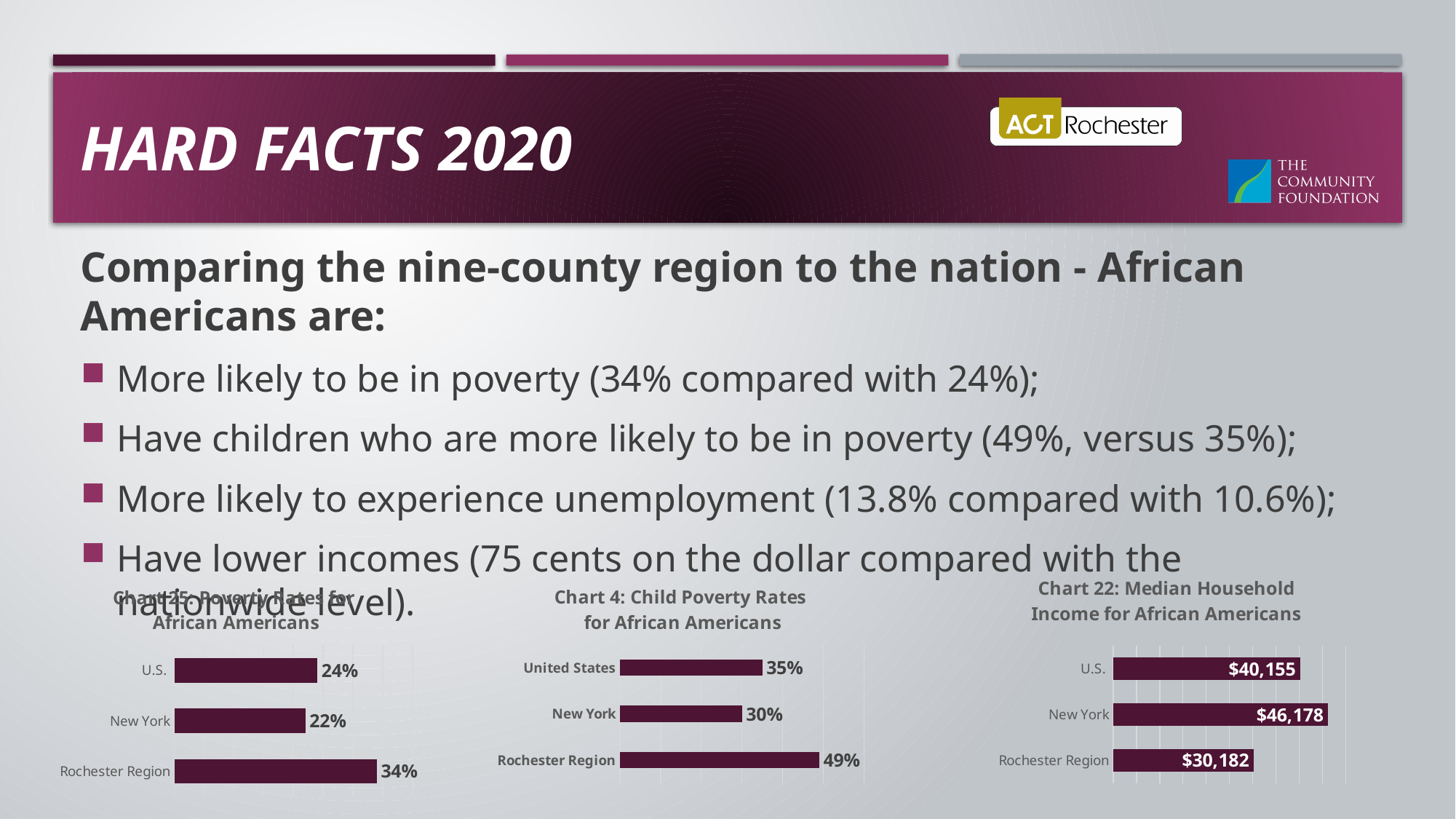
In Chart 22: Median Household Income for African Americans, which is larger, U.S. or Rochester Region? U.S. In Chart 4: Child Poverty Rates for African Americans, what is the difference between Rochester Region and New York? 19% In Chart 4: Child Poverty Rates for African Americans, which category has the highest value? Rochester Region In the left chart (Poverty Rates for African Americans), what is the value for Rochester Region? 34% In the left chart (Poverty Rates for African Americans), what is the value for New York? 22% How many categories are shown in Chart 4: Child Poverty Rates for African Americans? 3 In Chart 4: Child Poverty Rates for African Americans, what is the value for United States? 35% In the left chart (Poverty Rates for African Americans), what is the difference between Rochester Region and U.S.? 10% In Chart 22: Median Household Income for African Americans, what is the value for New York? $46,178 In the left chart (Poverty Rates for African Americans), which category has the lowest value? New York In Chart 22: Median Household Income for African Americans, which category has the lowest value? Rochester Region What type of chart is Chart 22: Median Household Income for African Americans? Bar chart